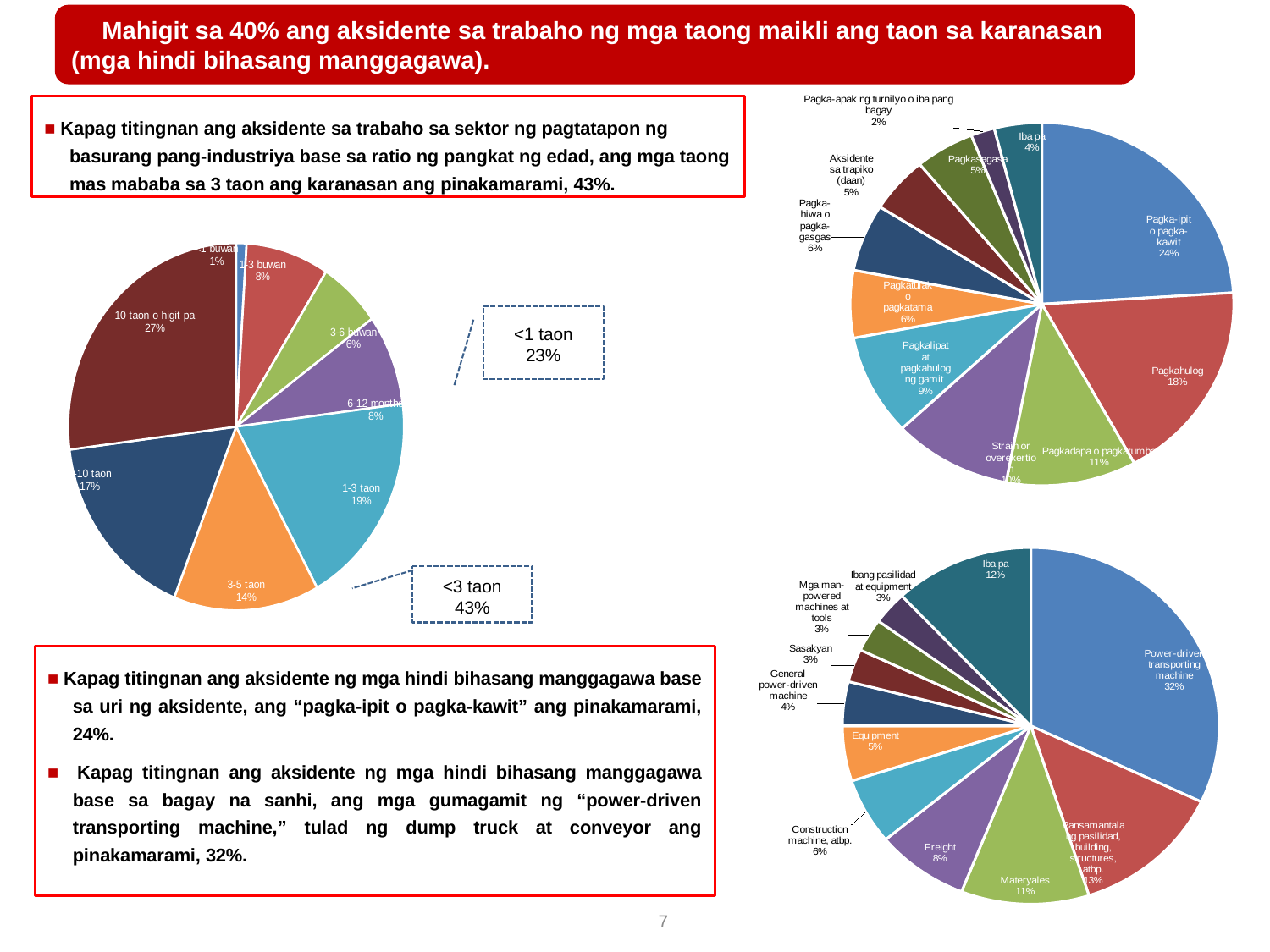
In the pie chart at the bottom right of the slide, what is the difference in percentage points between "Freight" and "Equipment"? 3 In the pie chart at the bottom right of the slide, what share is labelled for "Power-driven transporting machine"? 32% In the pie chart on the left of the slide, which category has the largest share? 10 taon o higit pa In the pie chart at the bottom right of the slide, what share is labelled for "Materyales"? 11% What kind of chart is shown at the bottom right of the slide? Pie chart In the pie chart at the top right of the slide, which is larger: "Pagkadapa o pagkatumba" or "Pagkasagasa"? Pagkadapa o pagkatumba In the pie chart on the left of the slide, what share does the callout give for "<3 taon"? 43% In the pie chart at the top right of the slide, what share is labelled for "Pagkahulog"? 18% In the pie chart on the left of the slide, what is the difference in percentage points between "1-3 taon" and "3-5 taon"? 5 In the pie chart on the left of the slide, what share is labelled for "10 taon o higit pa"? 27% In the pie chart at the top right of the slide, which category has the largest share? Pagka-ipit o pagka-kawit In the pie chart on the left of the slide, which category has the smallest share? <1 buwan